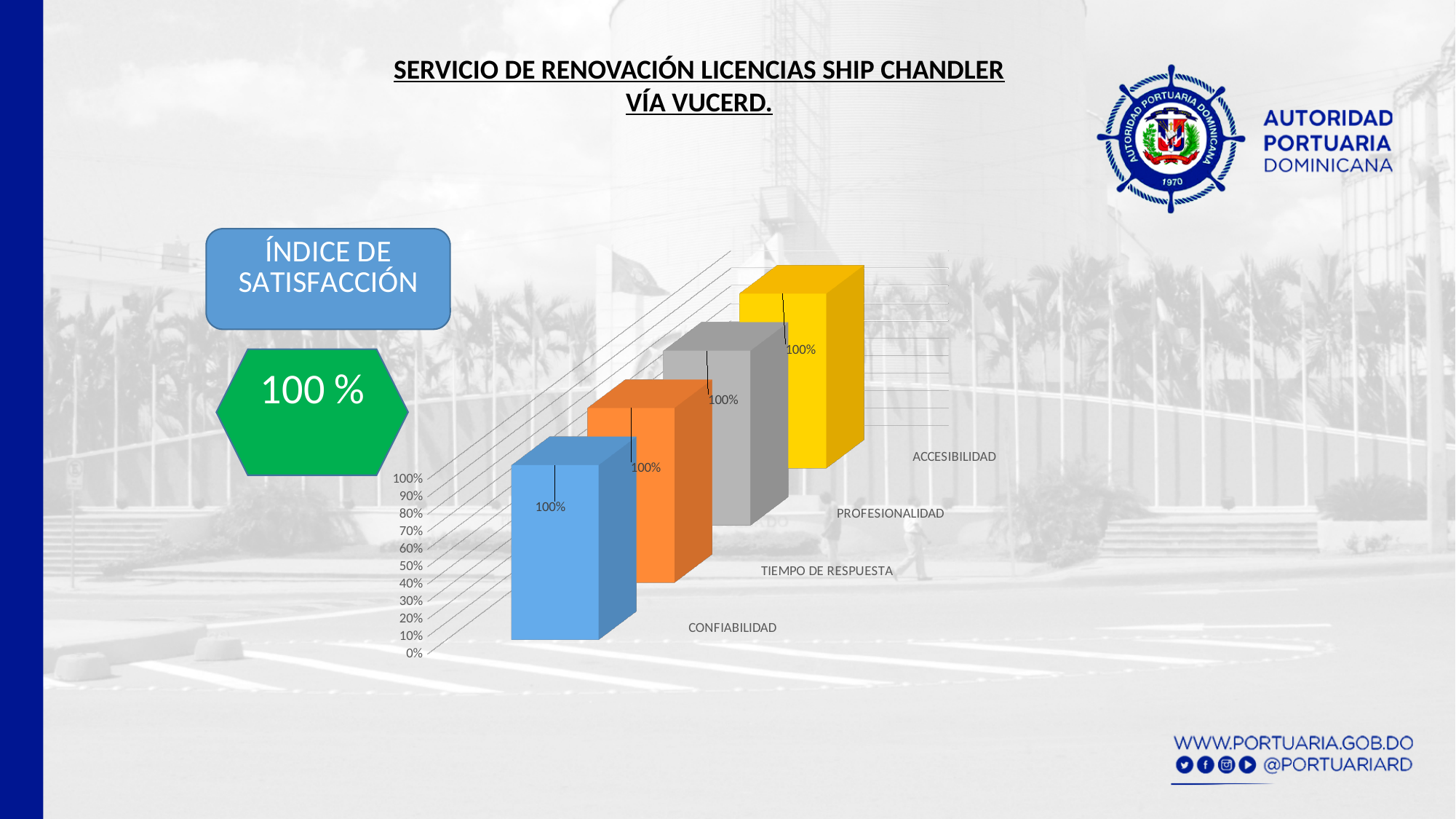
What is the value for CONFIABILIDAD? 100% Do the values rise, fall or stay the same across the categories from CONFIABILIDAD to ACCESIBILIDAD? stay the same What colour is the bar for ACCESIBILIDAD? yellow What is the highest value shown on the vertical axis of the chart? 100% Is the value for ACCESIBILIDAD greater or less than 90%? greater What kind of chart is shown on the slide? bar chart What is the value for ACCESIBILIDAD? 100% How many categories are plotted in the chart? 4 Is the value for CONFIABILIDAD greater or less than 50%? greater What is the difference between the values for PROFESIONALIDAD and CONFIABILIDAD? 0% What is the value for TIEMPO DE RESPUESTA? 100% What is the value for PROFESIONALIDAD? 100%